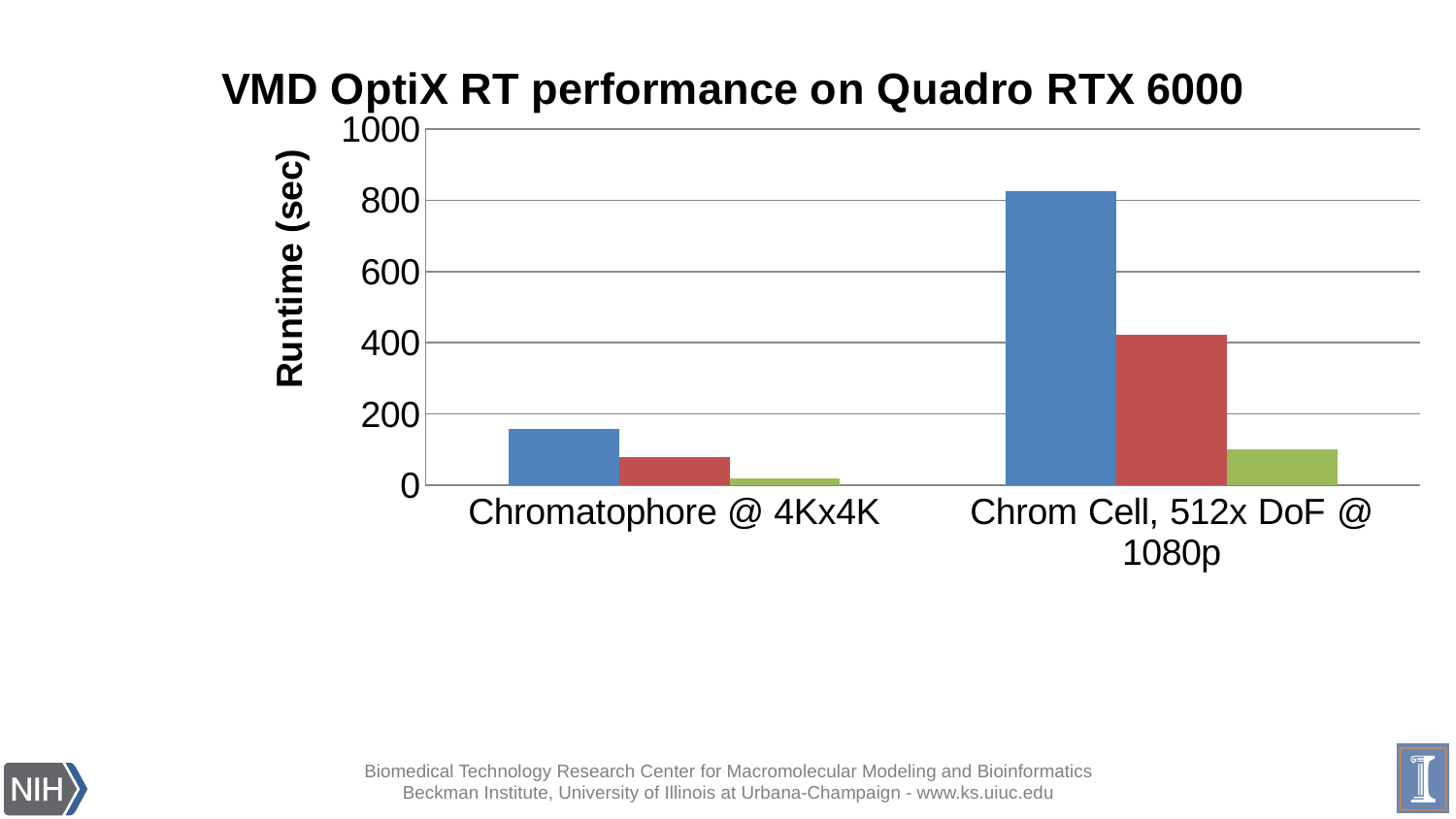
Is the value of the blue bar for Chromatophore @ 4Kx4K greater or less than 200? less What is the title of the chart? VMD OptiX RT performance on Quadro RTX 6000 What is the label on the vertical axis of the chart? Runtime (sec) Is the value of the green bar for Chrom Cell, 512x DoF @ 1080p greater or less than 200? less Which bar colour has the lowest value in the Chromatophore @ 4Kx4K category? green Which category has the tallest blue bar? Chrom Cell, 512x DoF @ 1080p Is the red bar for Chrom Cell, 512x DoF @ 1080p larger or smaller than the red bar for Chromatophore @ 4Kx4K? larger Is the value of the red bar for Chrom Cell, 512x DoF @ 1080p greater or less than 200? greater How many bars are plotted for each category in the chart? 3 How many categories are shown on the x axis of the chart? 2 What kind of chart is shown on the slide? bar chart